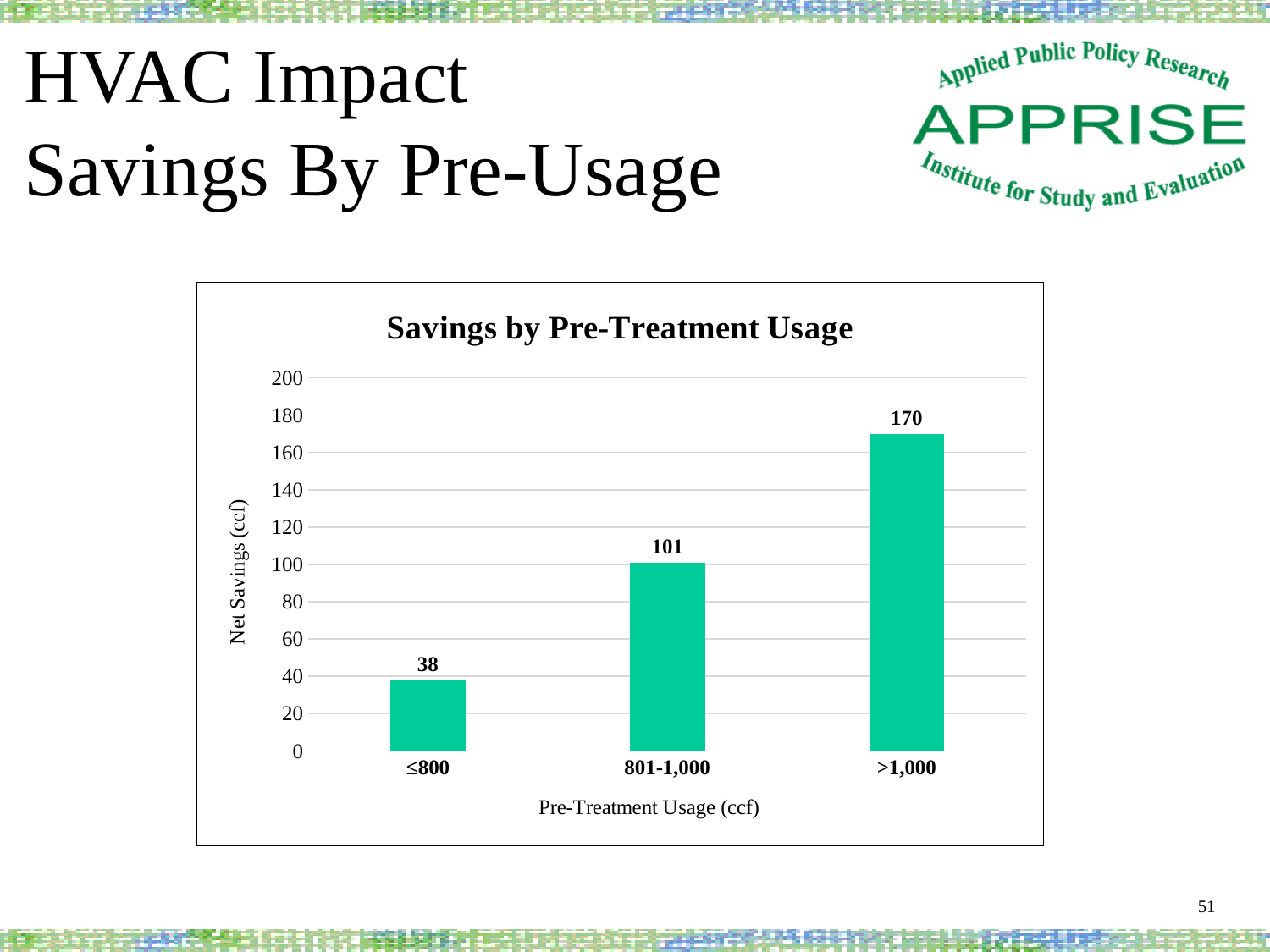
Do net savings rise or fall as pre-treatment usage increases along the x axis? rise What kind of chart is shown on the slide? bar chart What is the net savings for the >1,000 pre-treatment usage group? 170 Which pre-treatment usage group has the highest net savings? >1,000 What is the difference in net savings between the >1,000 group and the ≤800 group? 132 Which pre-treatment usage group has the lowest net savings? ≤800 What is the net savings for the 801-1,000 pre-treatment usage group? 101 How many pre-treatment usage groups are shown in the chart? 3 Is the net savings for the 801-1,000 group greater or less than 120? less What is the difference in net savings between the 801-1,000 group and the ≤800 group? 63 What is the net savings for the ≤800 pre-treatment usage group? 38 Which has larger net savings, the 801-1,000 group or the >1,000 group? >1,000